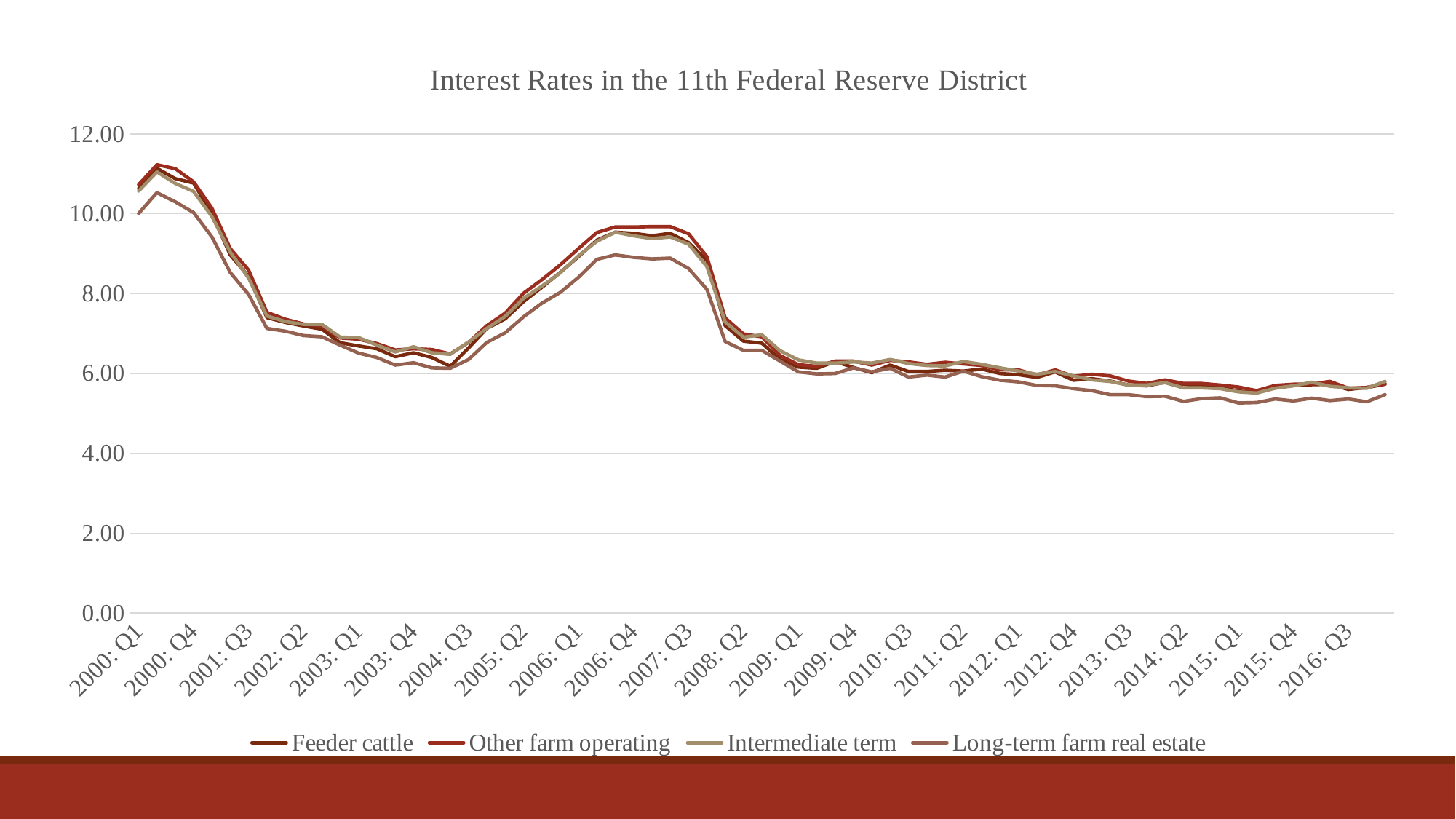
Is the value for Long-term farm real estate at 2002: Q2 greater or less than 8.00? less Is the value for Long-term farm real estate at 2016: Q3 greater or less than 6.00? less Is the value for Feeder cattle at 2000: Q1 greater or less than 10.00? greater Which series has the lowest value at 2006: Q4? Long-term farm real estate Which series is listed last in the legend? Long-term farm real estate How many series does the legend list? 4 What is the title of the chart? Interest Rates in the 11th Federal Reserve District Do the interest rates rise or fall between 2000: Q4 and 2001: Q3? fall At 2006: Q4, which is larger: Other farm operating or Long-term farm real estate? Other farm operating What kind of chart is shown on the slide? line chart Which series has the lowest value at 2000: Q1? Long-term farm real estate